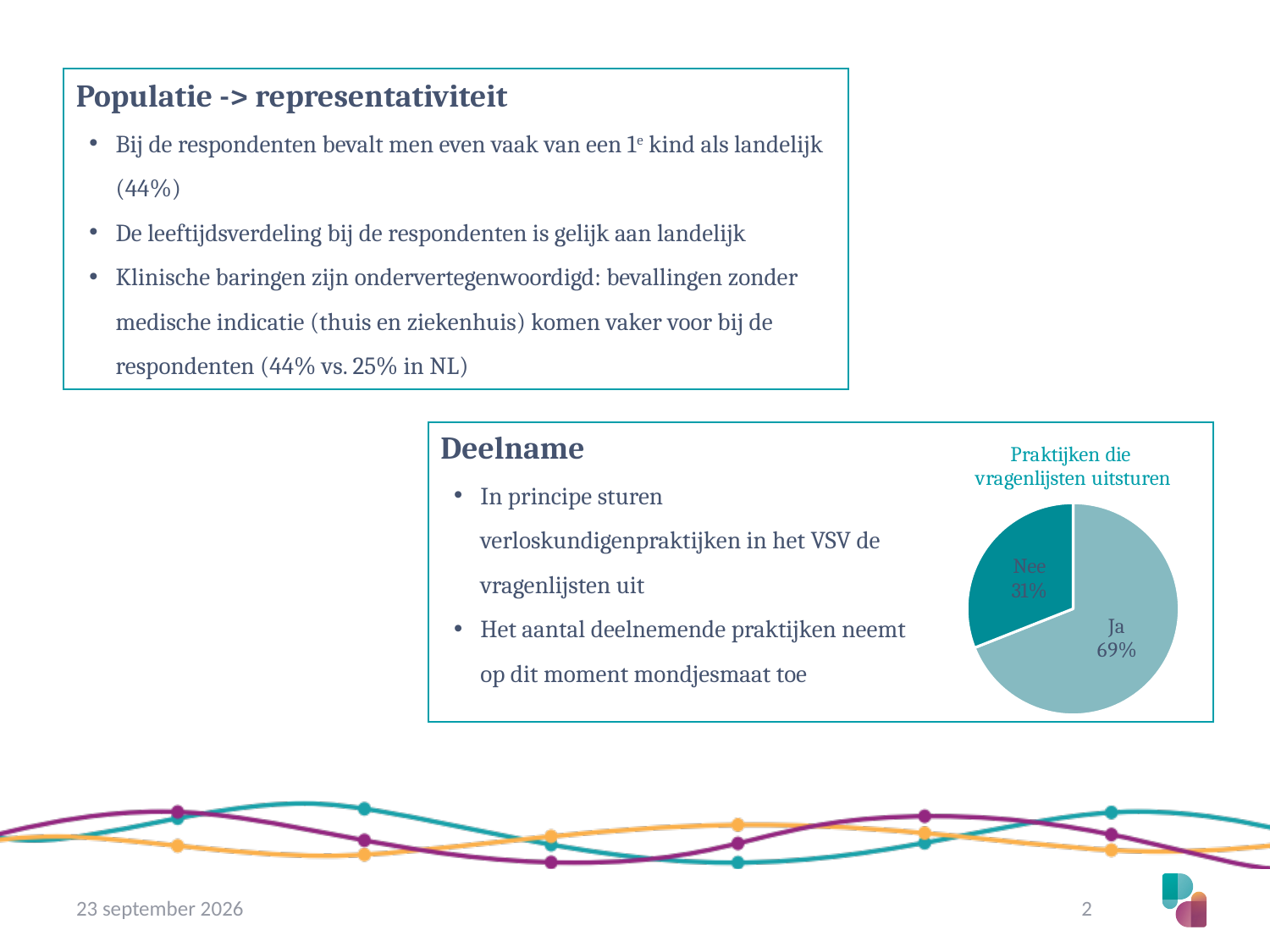
What share of the pie chart is labelled "Ja"? 69% Which slice of the pie chart is the largest? Ja Which slice of the pie chart is the smallest? Nee What kind of chart is shown on the slide? pie chart Is the value for "Nee" in the pie chart greater or less than 50%? less Which is larger in the pie chart, "Ja" or "Nee"? Ja How many slices does the pie chart have? 2 Is the value for "Ja" in the pie chart greater or less than 50%? greater Which slice of the pie chart is drawn in the darker teal colour? Nee What share of the pie chart is labelled "Nee"? 31% What is the title of the pie chart? Praktijken die vragenlijsten uitsturen What is the difference in percentage points between the "Ja" and "Nee" slices of the pie chart? 38